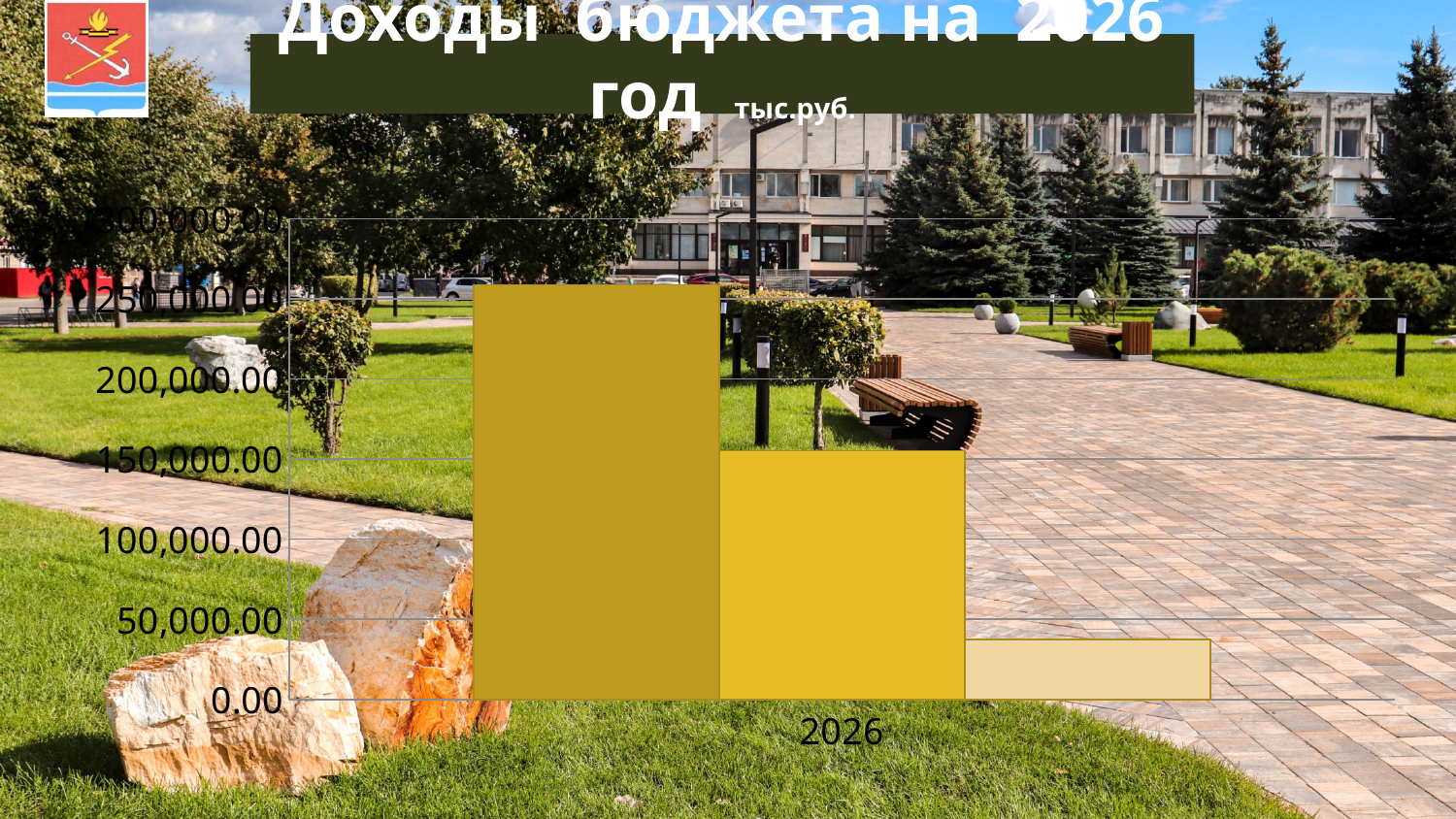
Is the value of the left bar greater or less than 200,000.00? greater Which bar is the tallest: the left, middle or right bar? left How many categories are shown on the x axis of the chart? 1 Is the value of the middle bar greater or less than 100,000.00? greater Is the value of the middle bar greater or less than 200,000.00? less What kind of chart is shown on the slide? bar chart What unit is indicated next to the chart title? тыс.руб. What is the title of the chart? Доходы бюджета на 2026 год Which bar is the shortest: the left, middle or right bar? right Which is larger, the middle bar or the right bar? middle bar What is the category label shown on the x axis? 2026